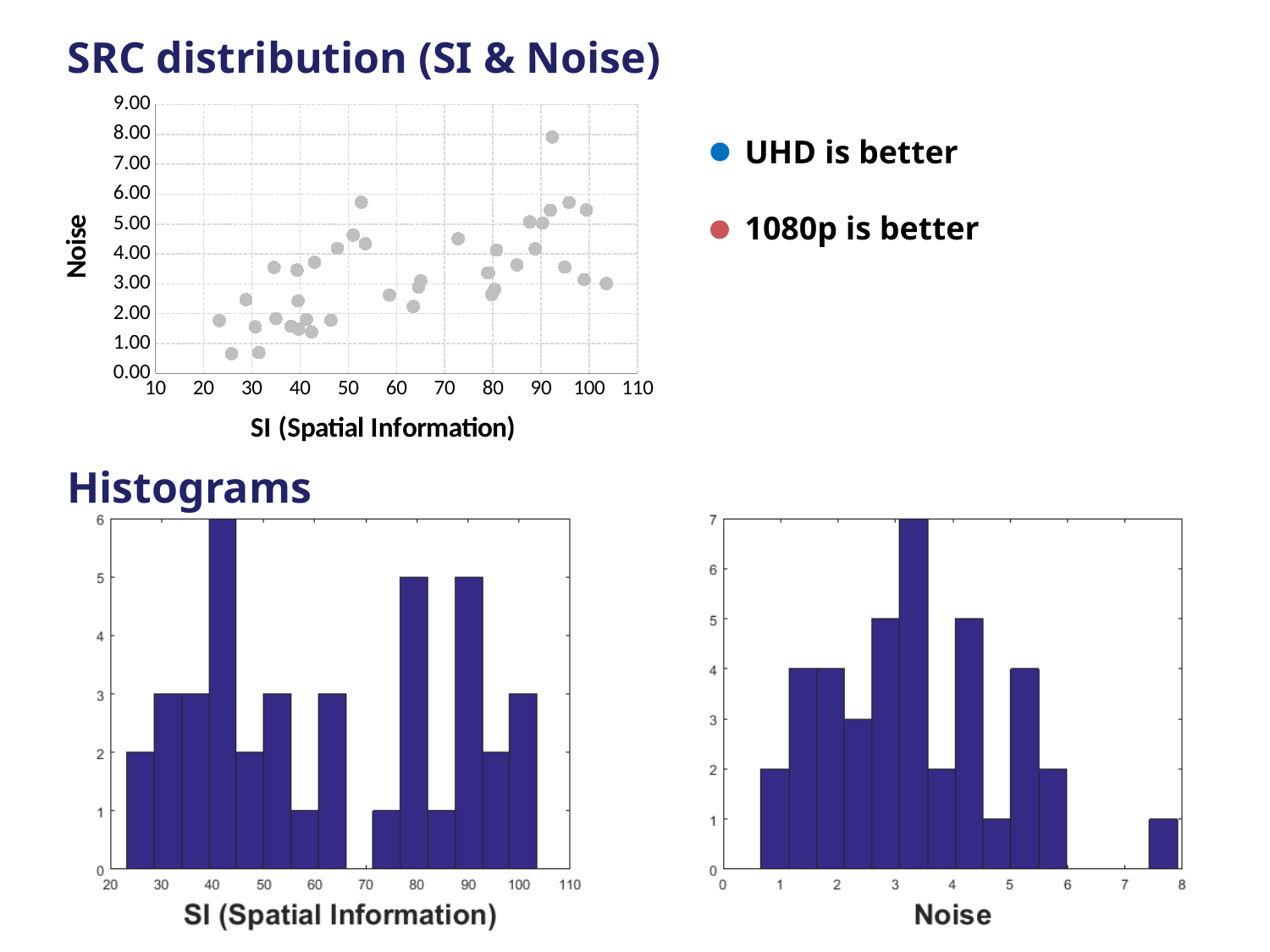
What kind of charts are the two charts under the 'Histograms' heading? bar charts What is the x-axis label of the 'SRC distribution (SI & Noise)' scatter chart? SI (Spatial Information) In the bottom-left histogram of SI (Spatial Information), what is the height of the tallest bar? 6 In the bottom-right histogram of Noise, what is the height of the rightmost bar (between 7 and 8)? 1 Which histogram has the taller maximum bar, the SI (Spatial Information) histogram or the Noise histogram? Noise histogram In the 'SRC distribution (SI & Noise)' scatter chart, is the Noise value of the lowest point greater or less than 1.00? less How many entries does the legend next to the 'SRC distribution (SI & Noise)' chart list? 2 What kind of chart is the top chart titled 'SRC distribution (SI & Noise)'? scatter chart In the 'SRC distribution (SI & Noise)' scatter chart, is the Noise value of the highest point greater or less than 7.00? greater In the bottom-right histogram of Noise, what is the height of the tallest bar? 7 In the bottom-left histogram of SI (Spatial Information), how many bars reach a height of 5? 2 What are the two legend entries shown next to the 'SRC distribution (SI & Noise)' chart? UHD is better; 1080p is better